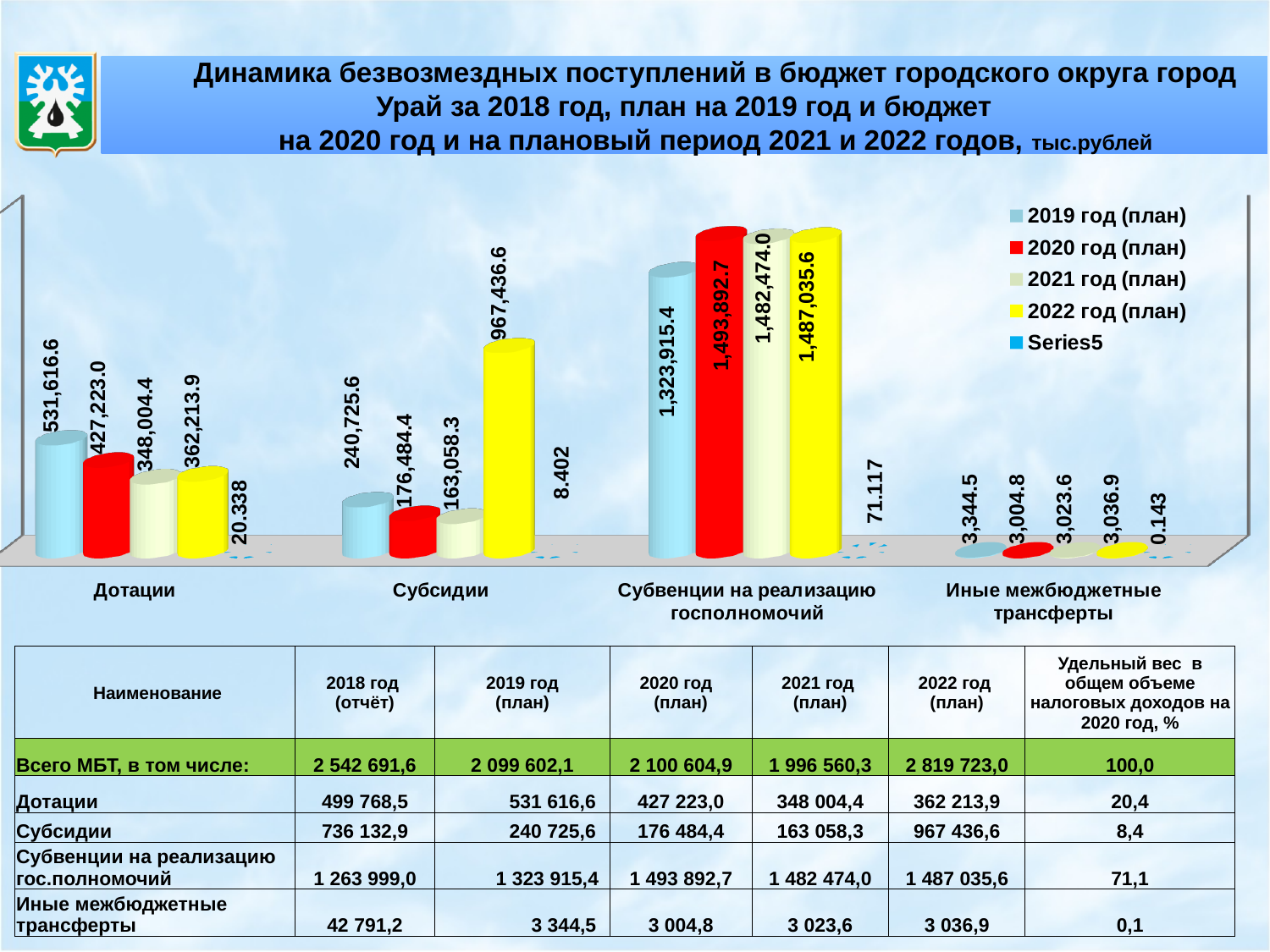
What kind of chart is shown on the slide? Bar chart Which is larger for Субсидии: the 2019 год (план) value or the 2020 год (план) value? 2019 год (план) What is the value for Субвенции на реализацию госполномочий in the 2020 год (план) series? 1,493,892.7 What is the value for Субсидии in the 2022 год (план) series? 967,436.6 Which category has the highest value in the 2022 год (план) series? Субвенции на реализацию госполномочий How many categories are shown on the x axis of the chart? 4 What is the value for Дотации in the 2019 год (план) series? 531,616.6 What is the value for Иные межбюджетные трансферты in the 2021 год (план) series? 3,023.6 Which colour represents the 2022 год (план) series in the chart? Yellow Which category has the lowest value in the 2019 год (план) series? Иные межбюджетные трансферты What is the difference between the 2019 год (план) and 2020 год (план) values for Дотации? 104,393.6 How many series does the chart legend list? 5